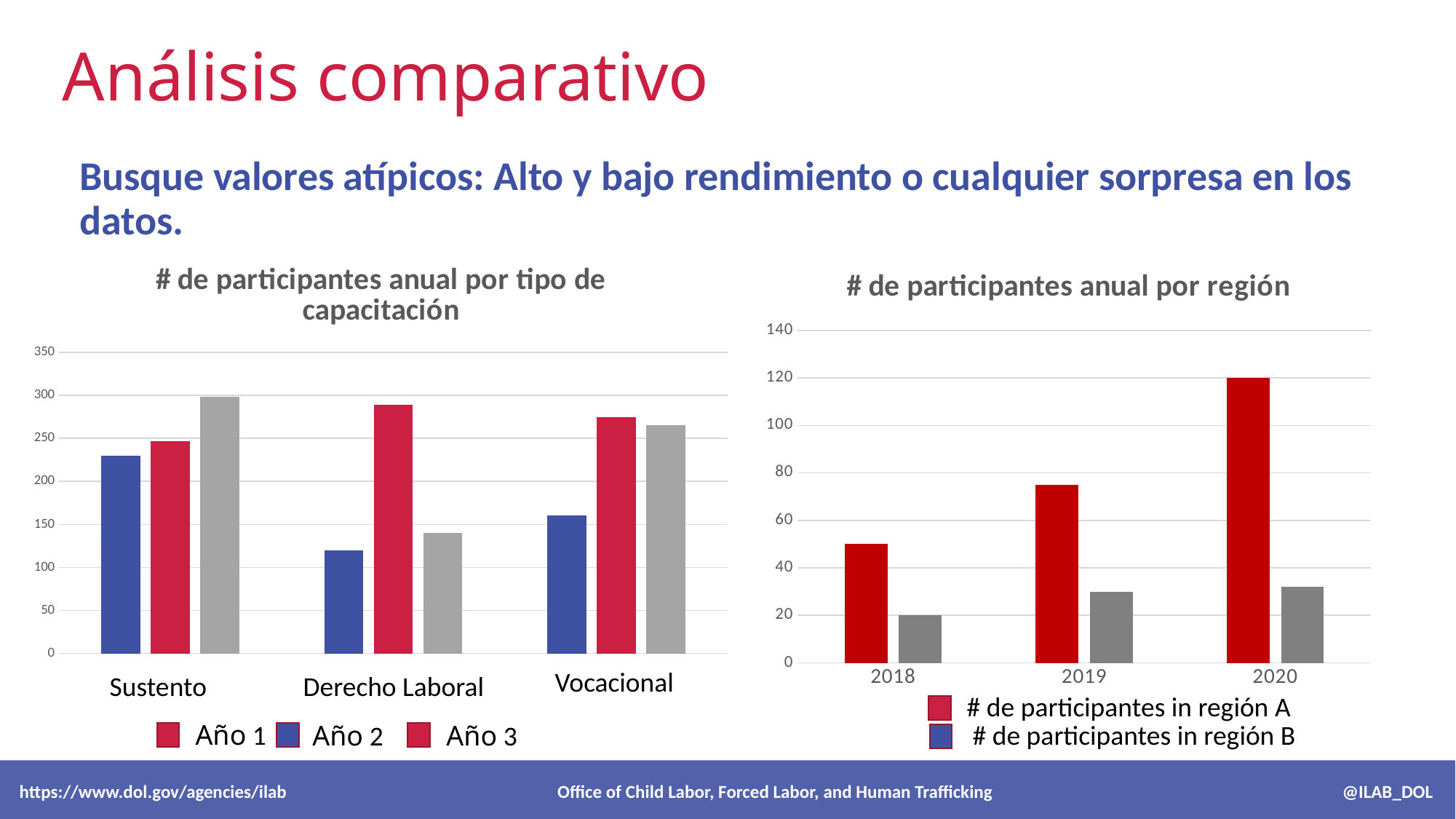
In the chart '# de participantes anual por tipo de capacitación', how many training types are shown on the x axis? 3 In the chart '# de participantes anual por región', do the values for región A rise or fall from 2018 to 2020? rise What kind of chart is '# de participantes anual por tipo de capacitación'? bar chart In the chart '# de participantes anual por región', how many series does the legend list? 2 In the chart '# de participantes anual por región', what is the value for región B in 2018? 20 In the chart '# de participantes anual por región', which is larger in 2019, región A or región B? región A In the chart '# de participantes anual por región', which year has the highest value for región A? 2020 In the chart '# de participantes anual por tipo de capacitación', is the tallest bar for Sustento greater or less than 250? greater In the chart '# de participantes anual por tipo de capacitación', is the shortest bar for Derecho Laboral greater or less than 150? less In the chart '# de participantes anual por tipo de capacitación', how many series does the legend list? 3 In the chart '# de participantes anual por región', what is the value for región A in 2020? 120 In the chart '# de participantes anual por región', what is the difference between región A in 2020 and región B in 2018? 100